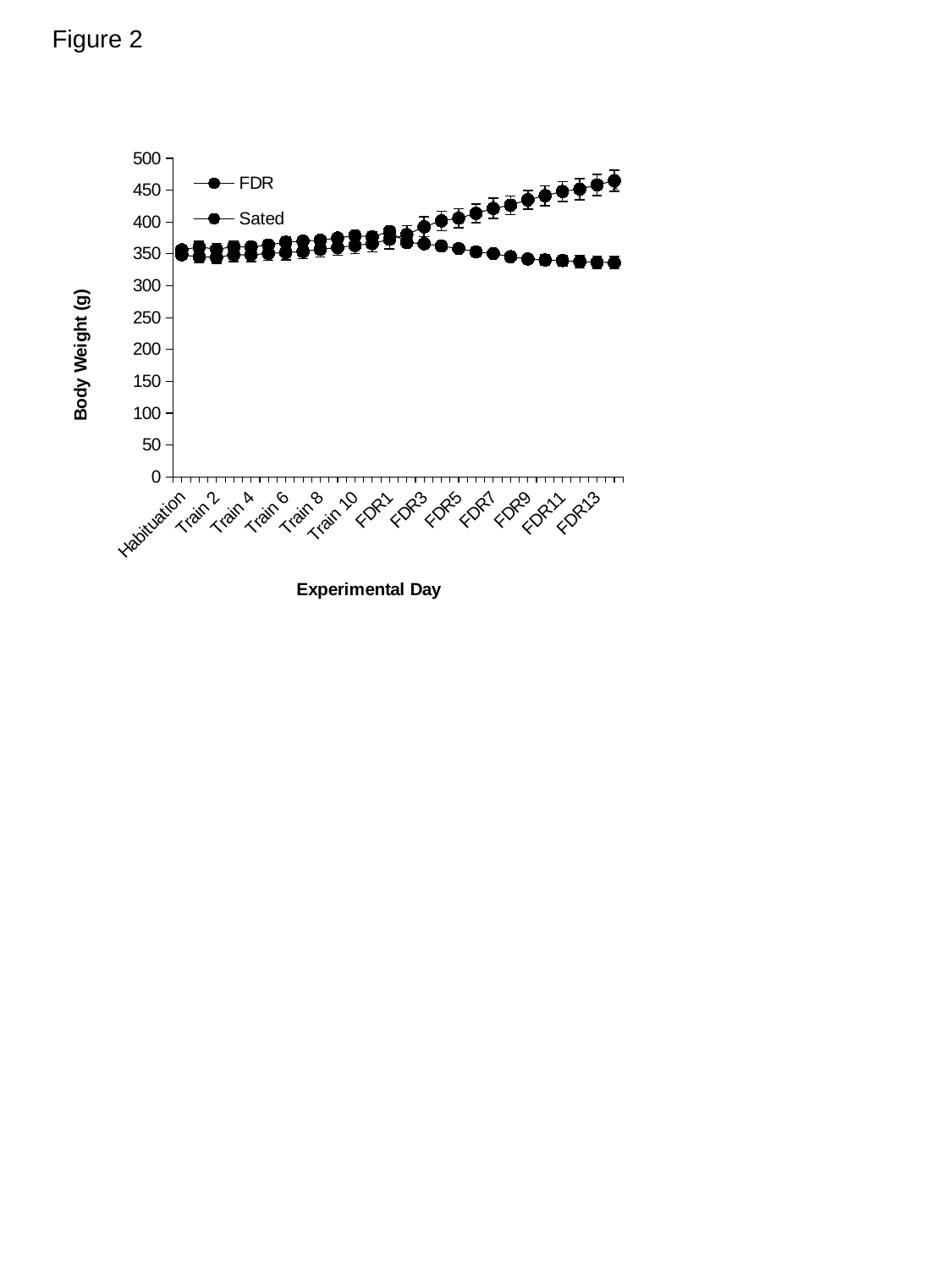
From FDR1 to FDR13, does the upper series rise or fall? rise What is the title of the y axis? Body Weight (g) How many category labels are printed along the x axis? 13 At FDR13, is the value of the lower series greater or less than 350? less What are the two series named in the legend? FDR and Sated At Habituation, are the values of both series greater or less than 300? greater After FDR1, do the two series diverge or converge? diverge How many series does the legend list? 2 At FDR1, are the values of both series greater or less than 400? less What kind of chart is shown on the slide? line chart From FDR1 to FDR13, does the lower series rise or fall? fall